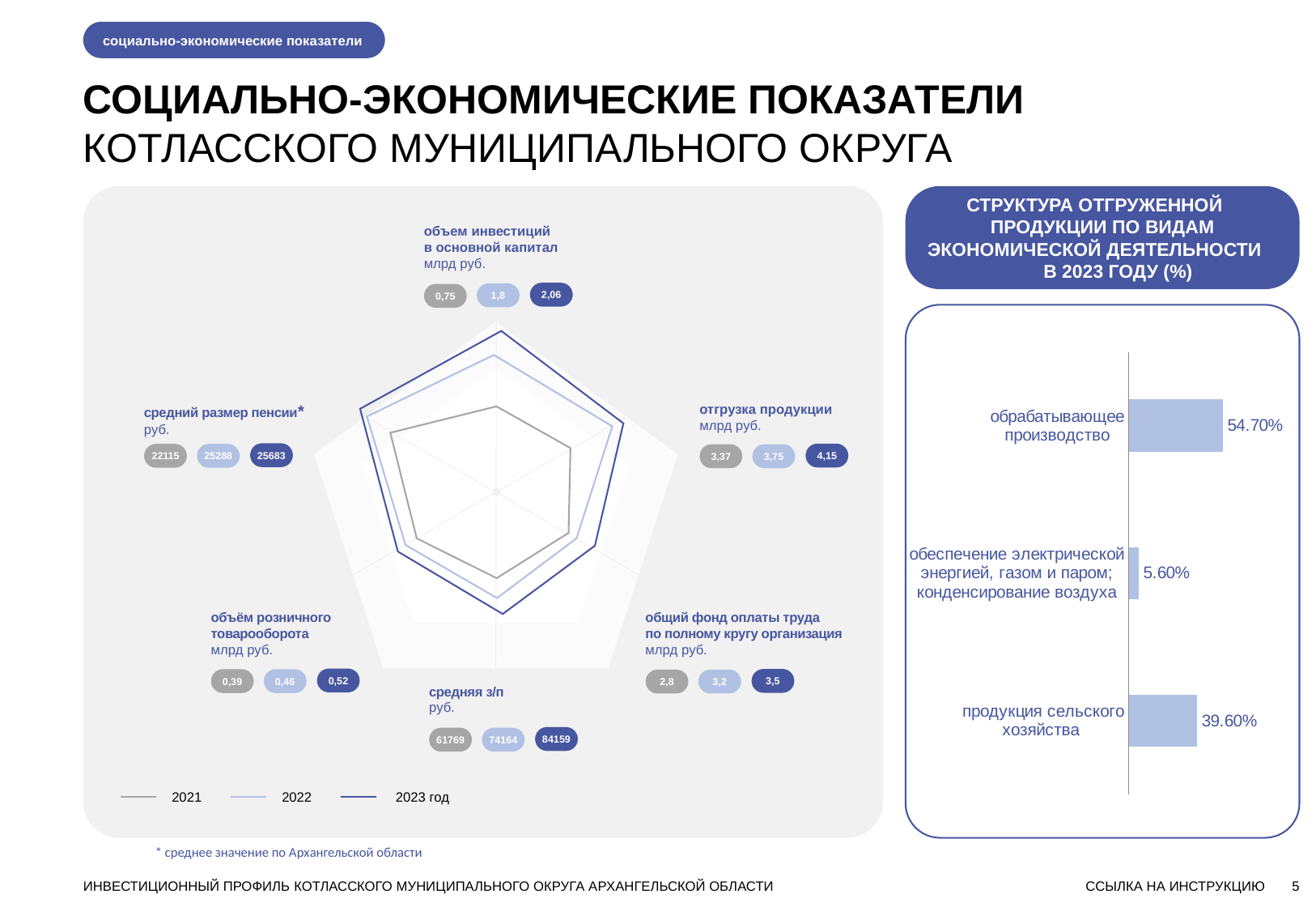
How many categories are shown in the bar chart on the right? 3 In the radar chart on the left, what is the value for средняя з/п in 2021? 61769 In the radar chart on the left, what is the difference between the 2023 and 2022 values for средний размер пенсии? 395 In the radar chart on the left, which year has the larger value for объём розничного товарооборота, 2022 or 2023? 2023 How many series does the legend of the radar chart on the left list? 3 In the radar chart on the left, what is the value for отгрузка продукции in 2023? 4,15 In the bar chart on the right, what is the value for обрабатывающее производство? 54.70% In the bar chart on the right, which category has the highest value? обрабатывающее производство In the bar chart on the right, which category has the lowest value? обеспечение электрической энергией, газом и паром; конденсирование воздуха In the radar chart on the left, do the values for объем инвестиций в основной капитал rise or fall from 2021 to 2023? rise What kind of chart is the chart on the right of the slide? bar chart In the bar chart on the right, what is the difference between the values for обрабатывающее производство and продукция сельского хозяйства? 15.10%